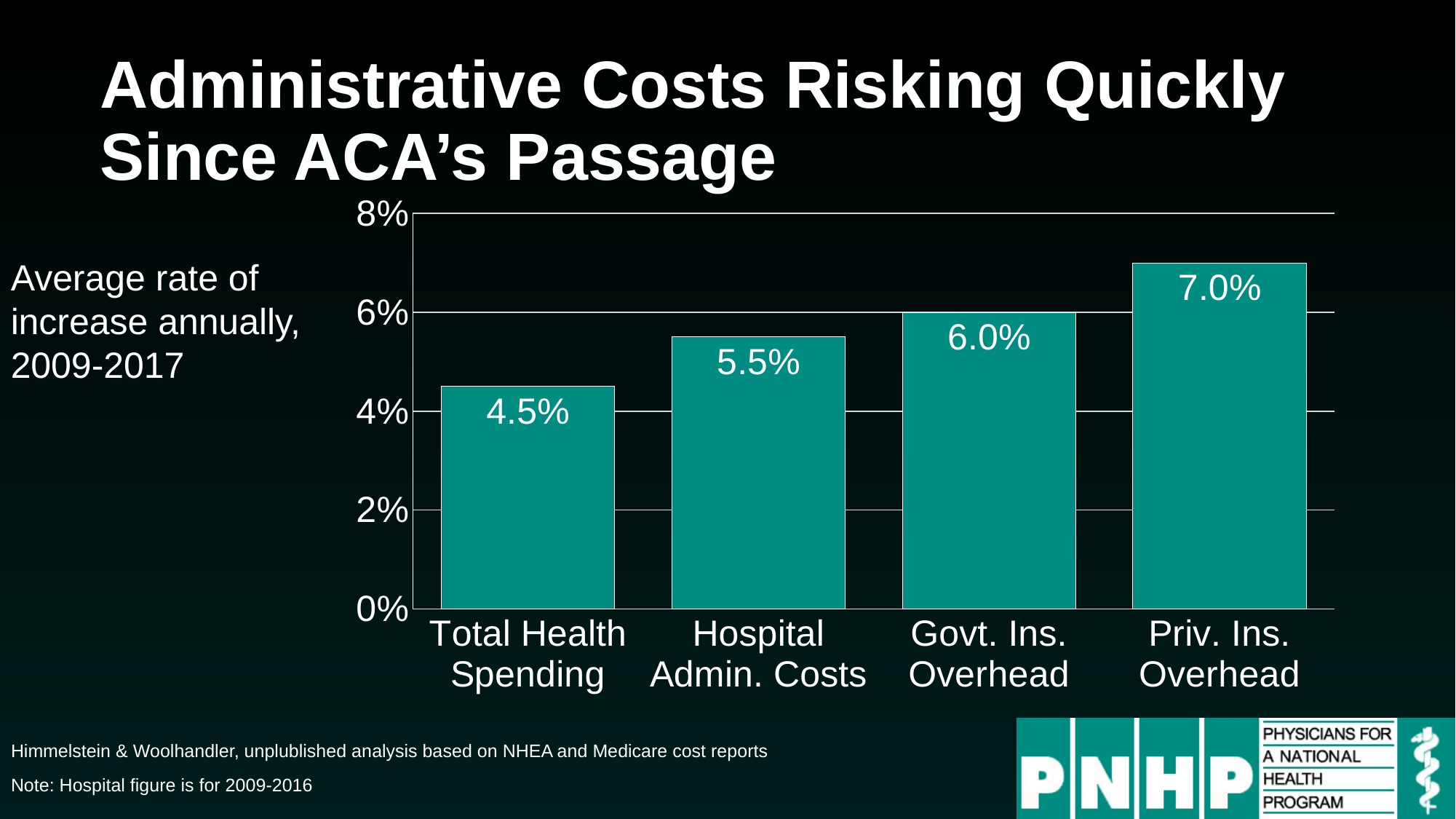
Is the value for Priv. Ins. Overhead greater or less than 6%? greater What is the average annual rate of increase for Priv. Ins. Overhead? 7.0% What is the difference between the rates for Priv. Ins. Overhead and Total Health Spending? 2.5% What is the average annual rate of increase for Total Health Spending? 4.5% What is the average annual rate of increase for Hospital Admin. Costs? 5.5% What kind of chart is shown on the slide? Bar chart How many categories are shown in the chart? 4 What is the average annual rate of increase for Govt. Ins. Overhead? 6.0% Do the values rise or fall from left to right across the categories? Rise Which is larger, the rate for Govt. Ins. Overhead or Hospital Admin. Costs? Govt. Ins. Overhead Which category has the lowest average annual rate of increase? Total Health Spending Which category has the highest average annual rate of increase? Priv. Ins. Overhead